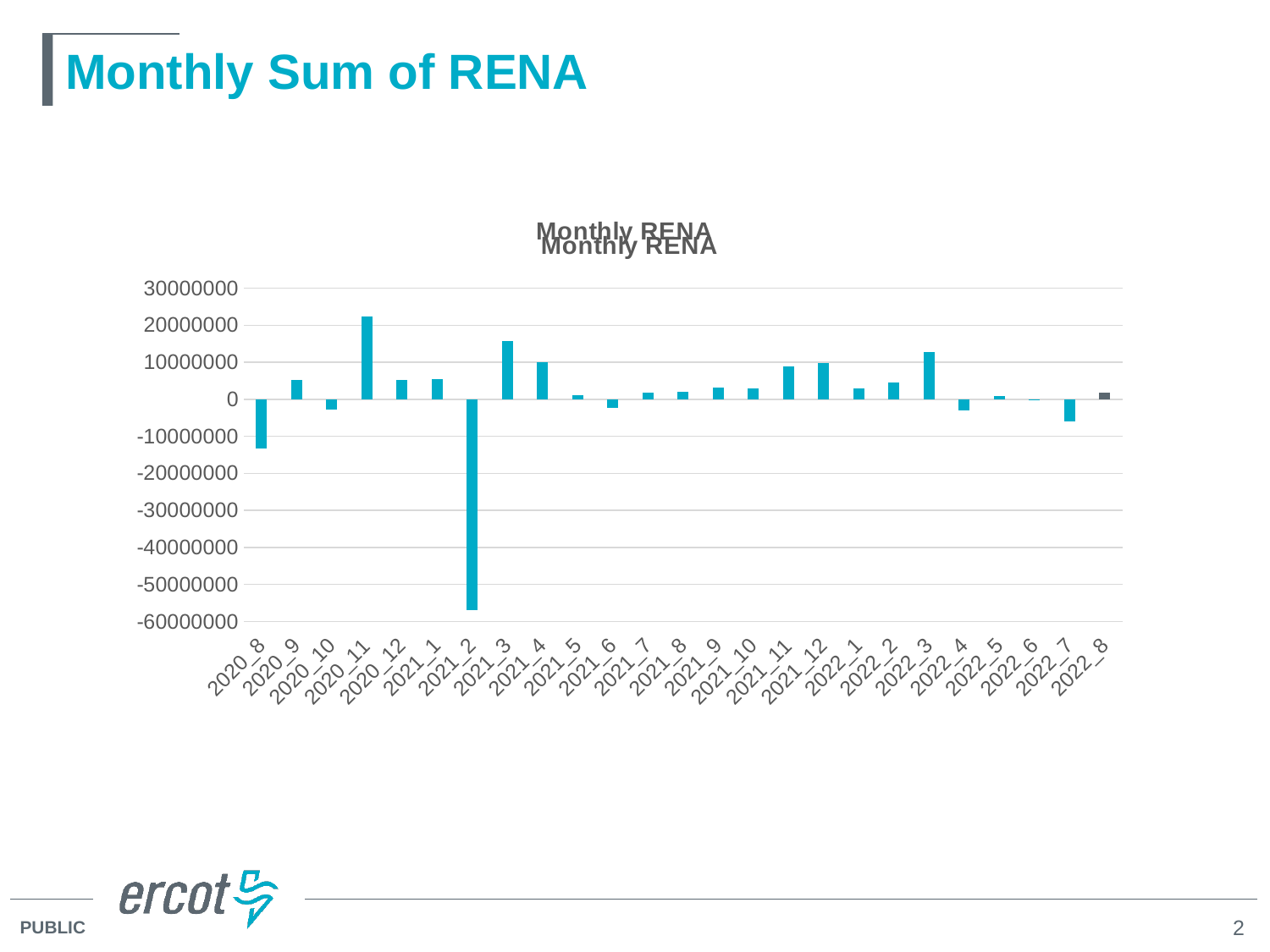
Which is larger, the value for 2020_11 or the value for 2021_3? 2020_11 Is the value for 2021_3 greater or less than 10000000? greater Which month has the highest value? 2020_11 Which bar is shown in a different colour from the rest? 2022_8 Which month has the lowest value? 2021_2 Is the value for 2021_11 greater or less than 10000000? less What type of chart is shown on the slide? bar chart How many monthly categories are plotted on the x axis? 25 Is the value for 2020_11 greater or less than 20000000? greater What is the title of the chart? Monthly RENA